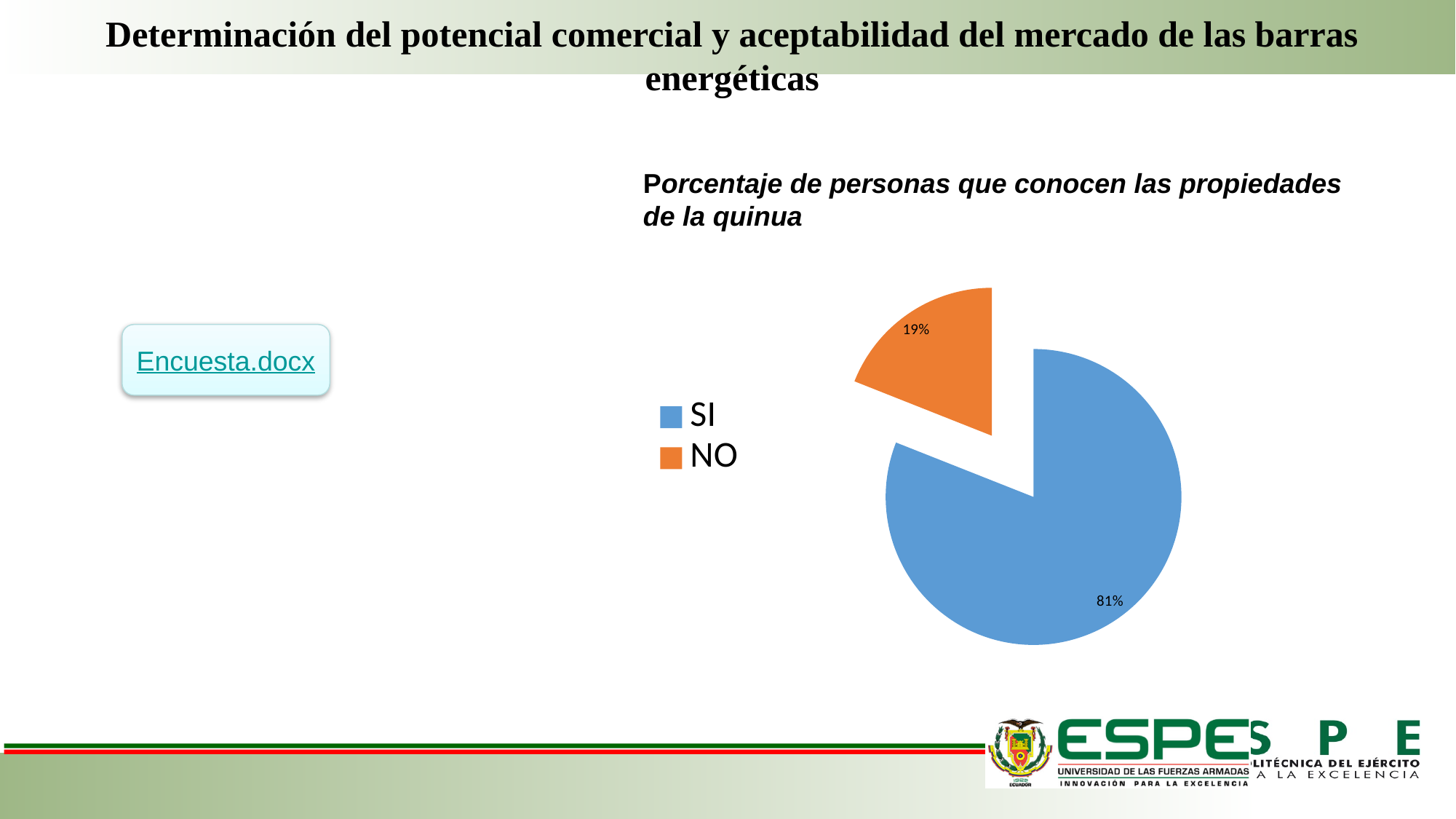
How many entries does the legend list? 2 What percentage of people answered NO in the pie chart? 19% What is the title of the chart? Porcentaje de personas que conocen las propiedades de la quinua What percentage of people answered SI (yes) in the pie chart? 81% What is the difference in percentage points between the SI and NO slices? 62 Which slice is larger, SI or NO? SI Which category has the smallest share of the pie chart? NO What colour is the SI slice in the pie chart? Blue What type of chart is shown on the slide? Pie chart How many slices does the pie chart have? 2 Which category has the largest share of the pie chart? SI What share of the pie does the NO slice represent? 19%